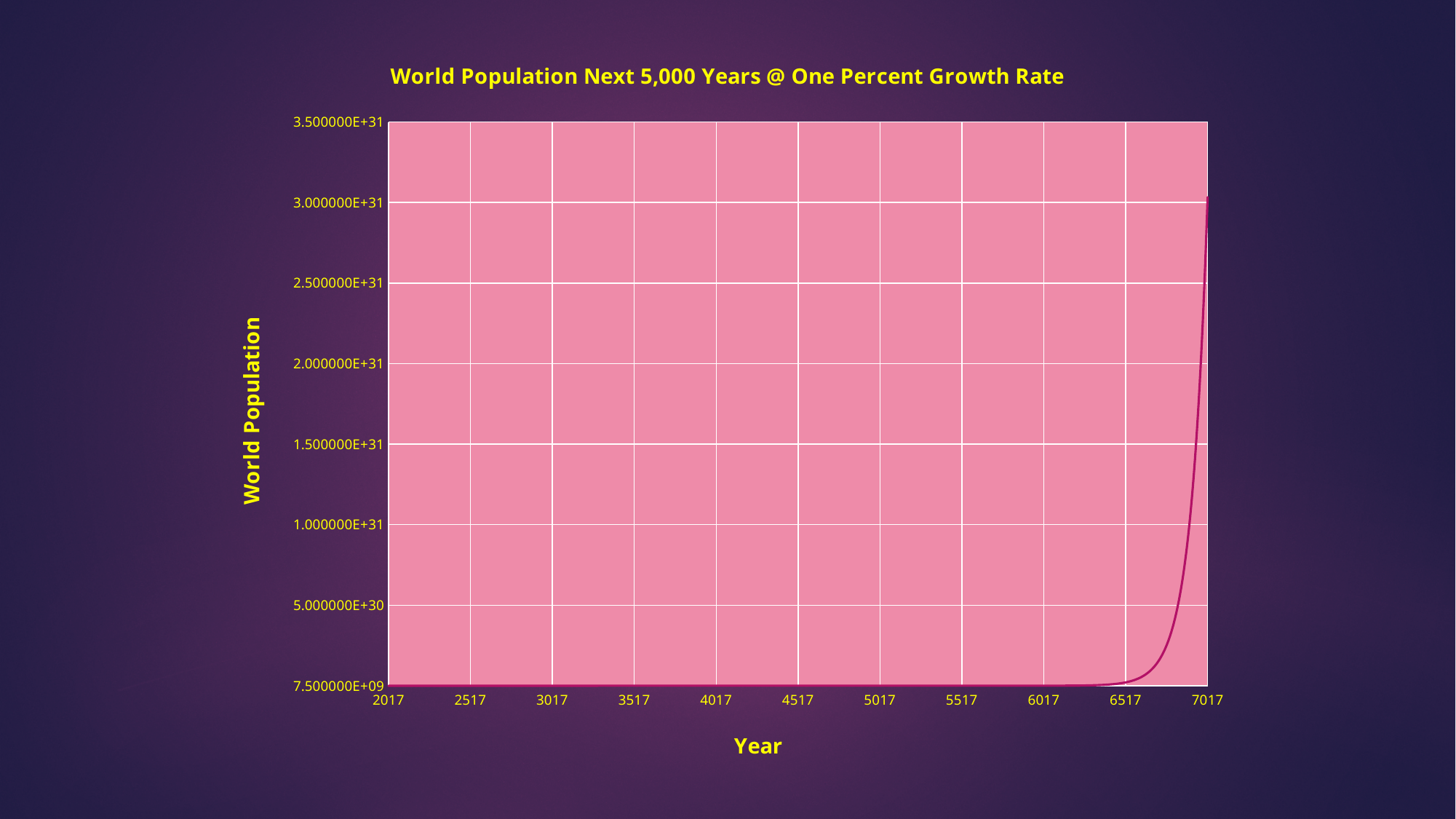
Is the world population value for 6517 greater or less than 5.000000E+30? less Is the world population value for 6017 greater or less than 1.000000E+31? less What is the world population value at the start of the line, in 2017? 7.500000E+09 Which year has the larger world population value, 6517 or 7017? 7017 Which year on the x axis has the highest world population value? 7017 Do the plotted values rise or fall as the year increases along the x axis? rise What is the label on the vertical axis of the chart? World Population What is the highest value labelled on the vertical axis? 3.500000E+31 Is the world population value for 7017 greater or less than 2.500000E+31? greater What kind of chart is shown on the slide? line chart What is the title of the chart? World Population Next 5,000 Years @ One Percent Growth Rate How many year labels are shown along the x axis? 11